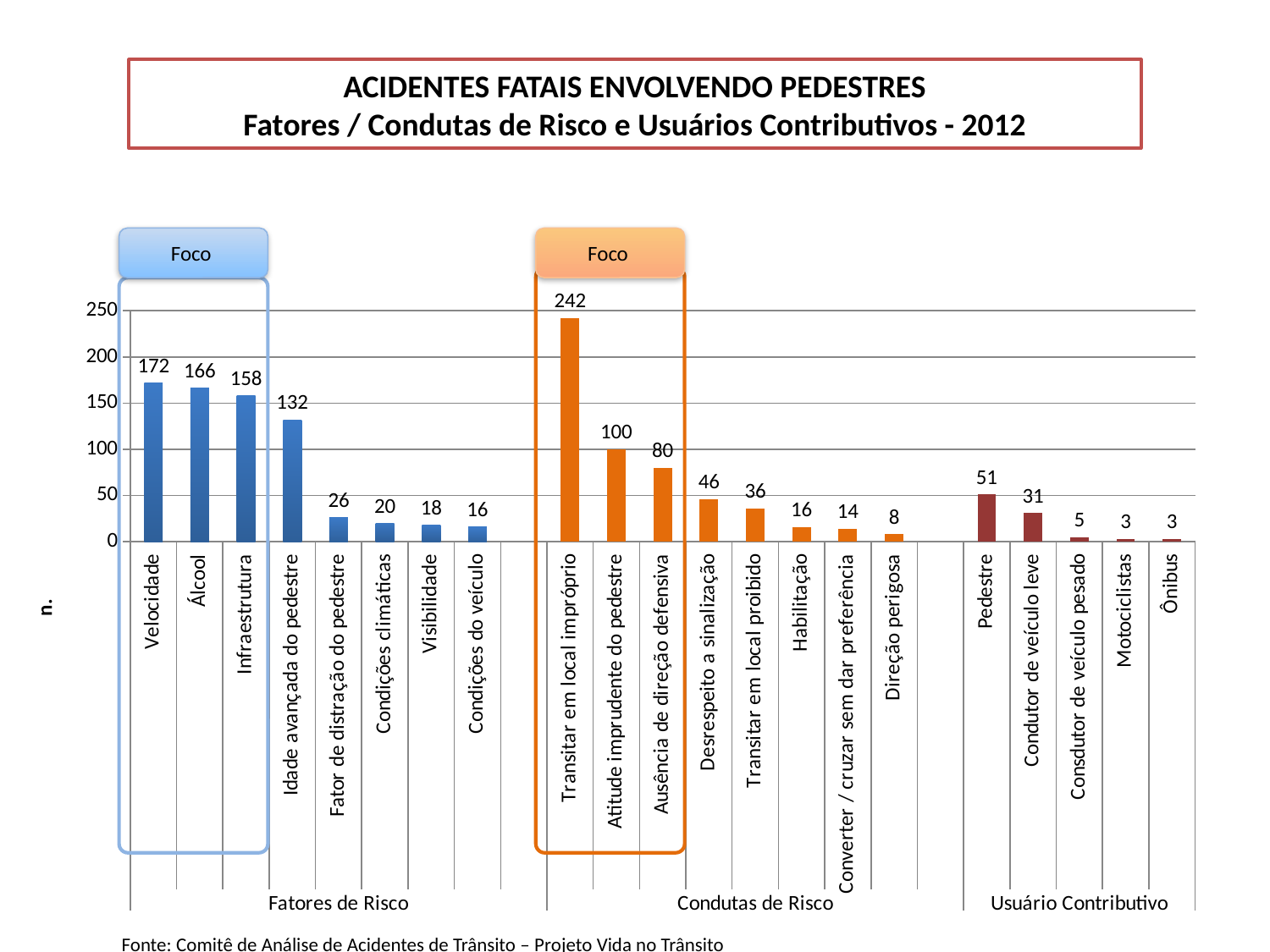
What is the value for Transitar em local impróprio? 242 What is the value for Velocidade? 172 How many categories are plotted on the chart in total? 21 What is the title of the chart? ACIDENTES FATAIS ENVOLVENDO PEDESTRES Fatores / Condutas de Risco e Usuários Contributivos - 2012 What is the value for Pedestre in the Usuário Contributivo group? 51 Which is larger, the value for Idade avançada do pedestre or the value for Ausência de direção defensiva? Idade avançada do pedestre What kind of chart is shown on the slide? Bar chart What is the difference between the values for Transitar em local impróprio and Atitude imprudente do pedestre? 142 What is the difference between the values for Velocidade and Álcool? 6 Which category has the highest value on the chart? Transitar em local impróprio Which category has the highest value within the Fatores de Risco group? Velocidade What is the value for Atitude imprudente do pedestre? 100